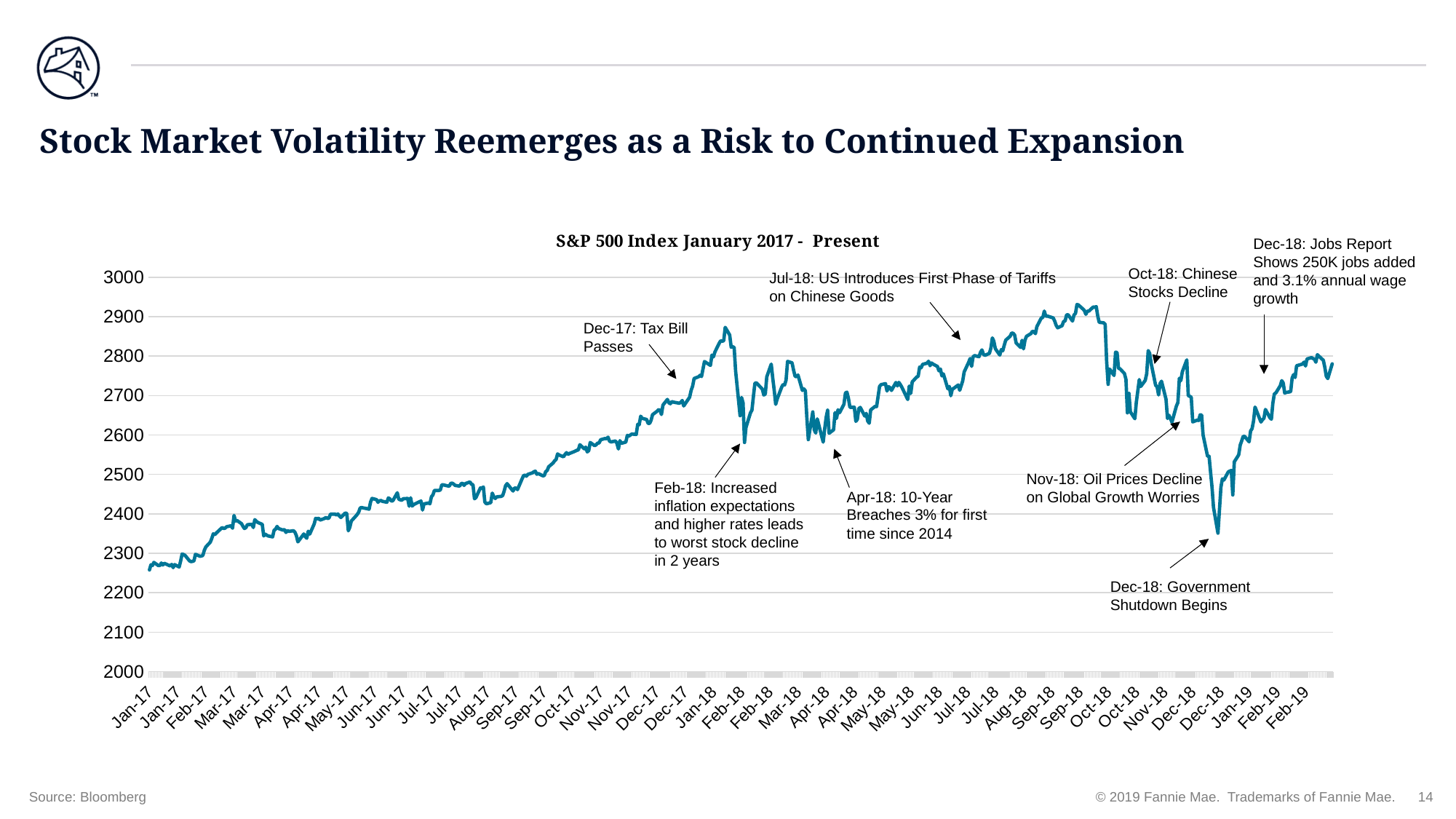
What kind of chart is shown on the slide? Line chart What is the title of the chart? S&P 500 Index January 2017 - Present Overall, does the S&P 500 Index rise or fall from Jan-17 to Feb-19? Rise Is the value of the S&P 500 Index at the start of Jan-17 greater or less than 2300? less What is the maximum value shown on the y-axis of the chart? 3000 How many data series are plotted on the chart? 1 Is the peak value of the S&P 500 Index in Sep-18 greater or less than 2900? greater Which is lower: the S&P 500 Index at the start of Jan-17 or at its Dec-18 low? Start of Jan-17 Is the lowest value of the S&P 500 Index in Dec-18 greater or less than 2400? less What event does the chart annotate for Dec-17? Tax Bill Passes Which is higher: the S&P 500 Index at its Sep-18 peak or at its Jan-18 peak? Sep-18 peak